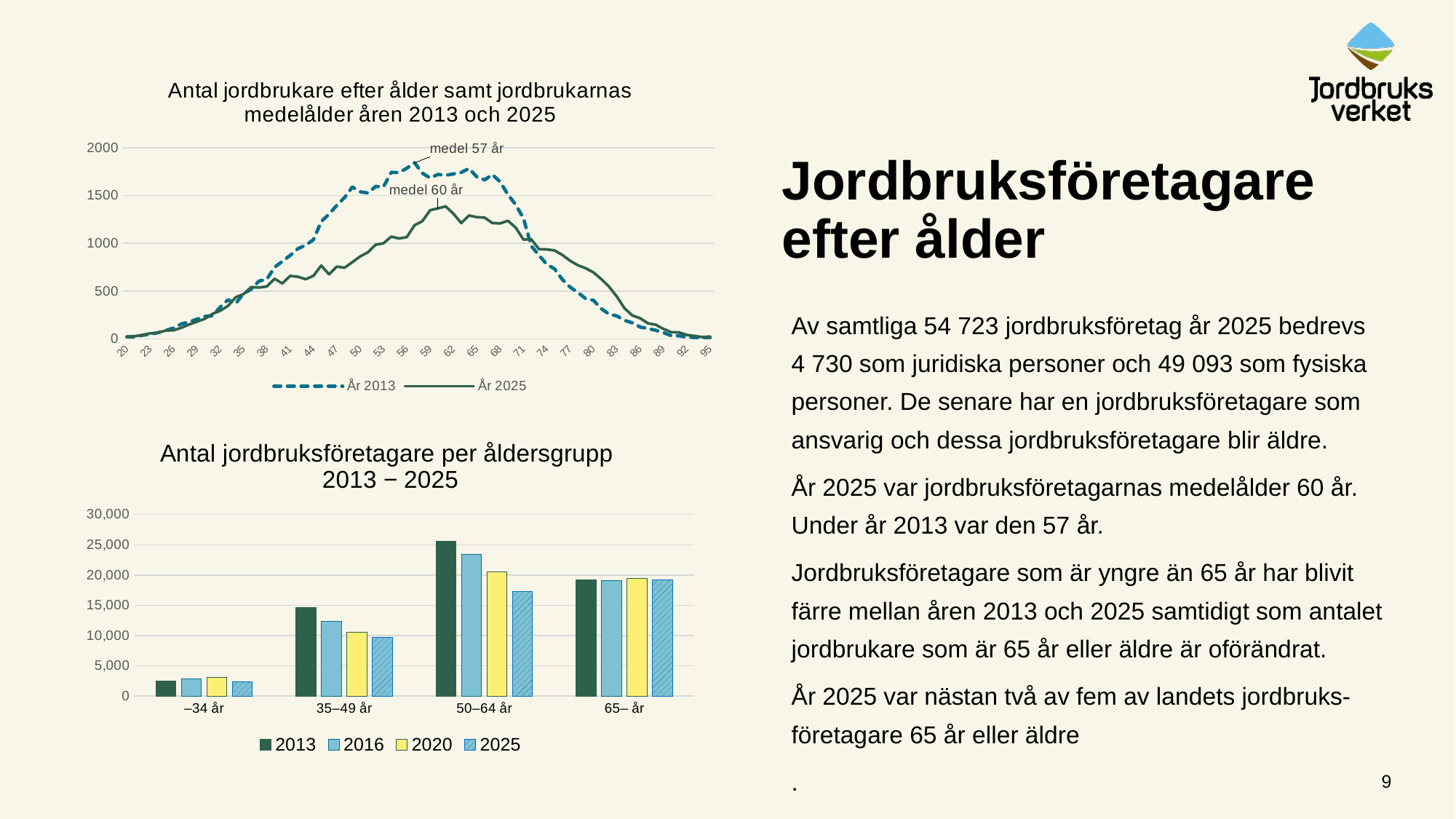
How many series does the legend of the bottom chart list? 4 In the top chart, is the peak value of the År 2013 line greater or less than 1500? greater How many series does the legend of the top chart list? 2 In the bottom chart, do the values for the 50–64 år group rise or fall from 2013 to 2025? fall How many age-group categories are shown on the x axis of the bottom chart? 4 In the top chart, which series is drawn with a dashed line? År 2013 What kind of chart is the top chart, 'Antal jordbrukare efter ålder samt jordbrukarnas medelålder åren 2013 och 2025'? line chart What kind of chart is the bottom chart, 'Antal jordbruksföretagare per åldersgrupp 2013 − 2025'? bar chart In the top chart, at age 80, which series has the larger value, År 2013 or År 2025? År 2025 In the top chart, is the peak value of the År 2025 line greater or less than 1500? less In the bottom chart, is the 2013 value for the 50–64 år group greater or less than 25,000? greater In the top chart, at age 50, which series has the larger value, År 2013 or År 2025? År 2013